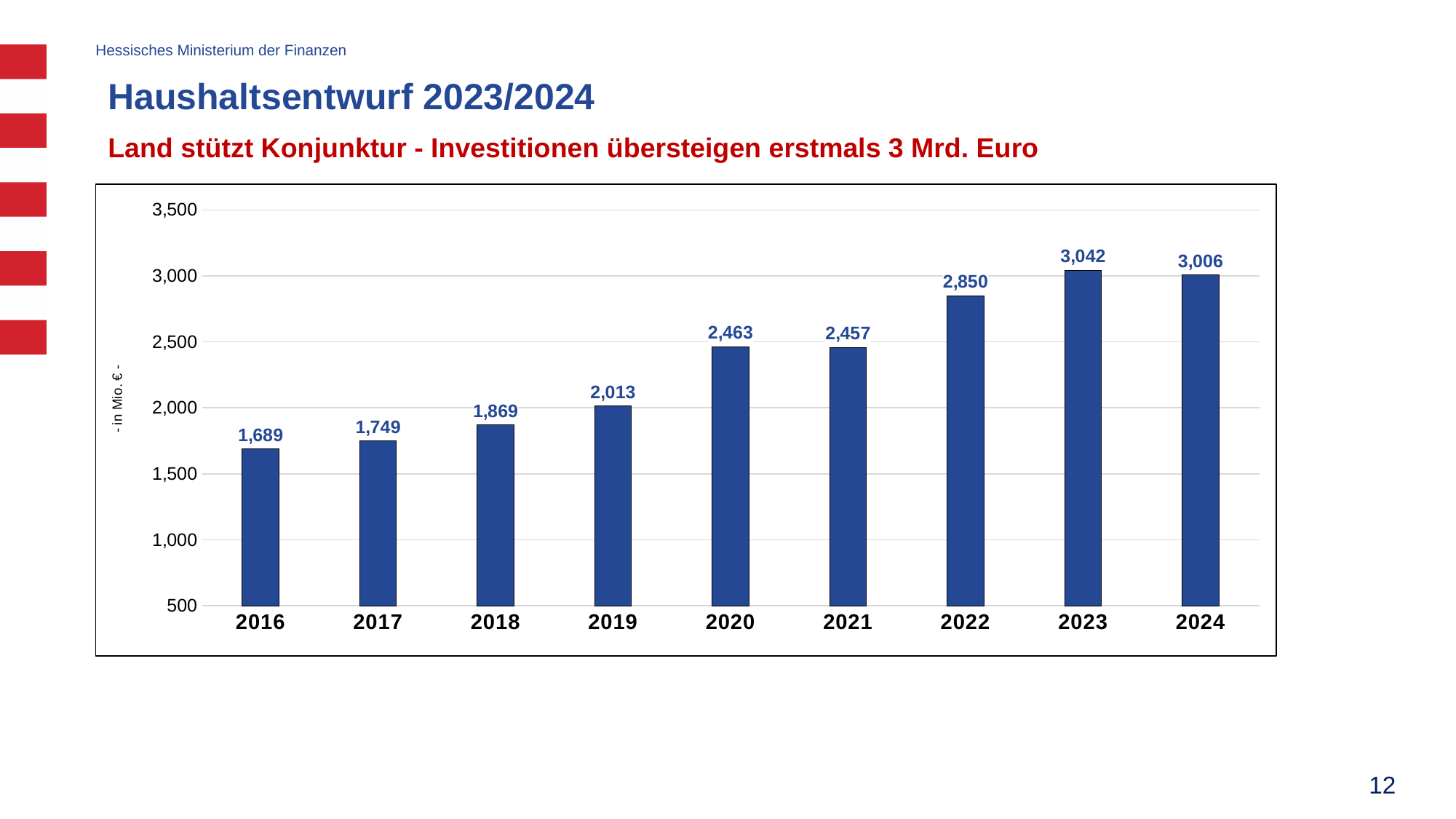
What unit is given on the y axis label? in Mio. € What is the value for 2016? 1,689 What is the difference between the values for 2022 and 2021? 393 What kind of chart is shown on the slide? bar chart How many years are shown on the x axis? 9 What is the value for 2024? 3,006 What is the value for 2022? 2,850 Which year has the lowest value? 2016 Which year has the highest value? 2023 Which is larger, the value for 2019 or the value for 2018? 2019 What is the difference between the values for 2023 and 2024? 36 Is the value for 2020 greater or less than 2,500? less